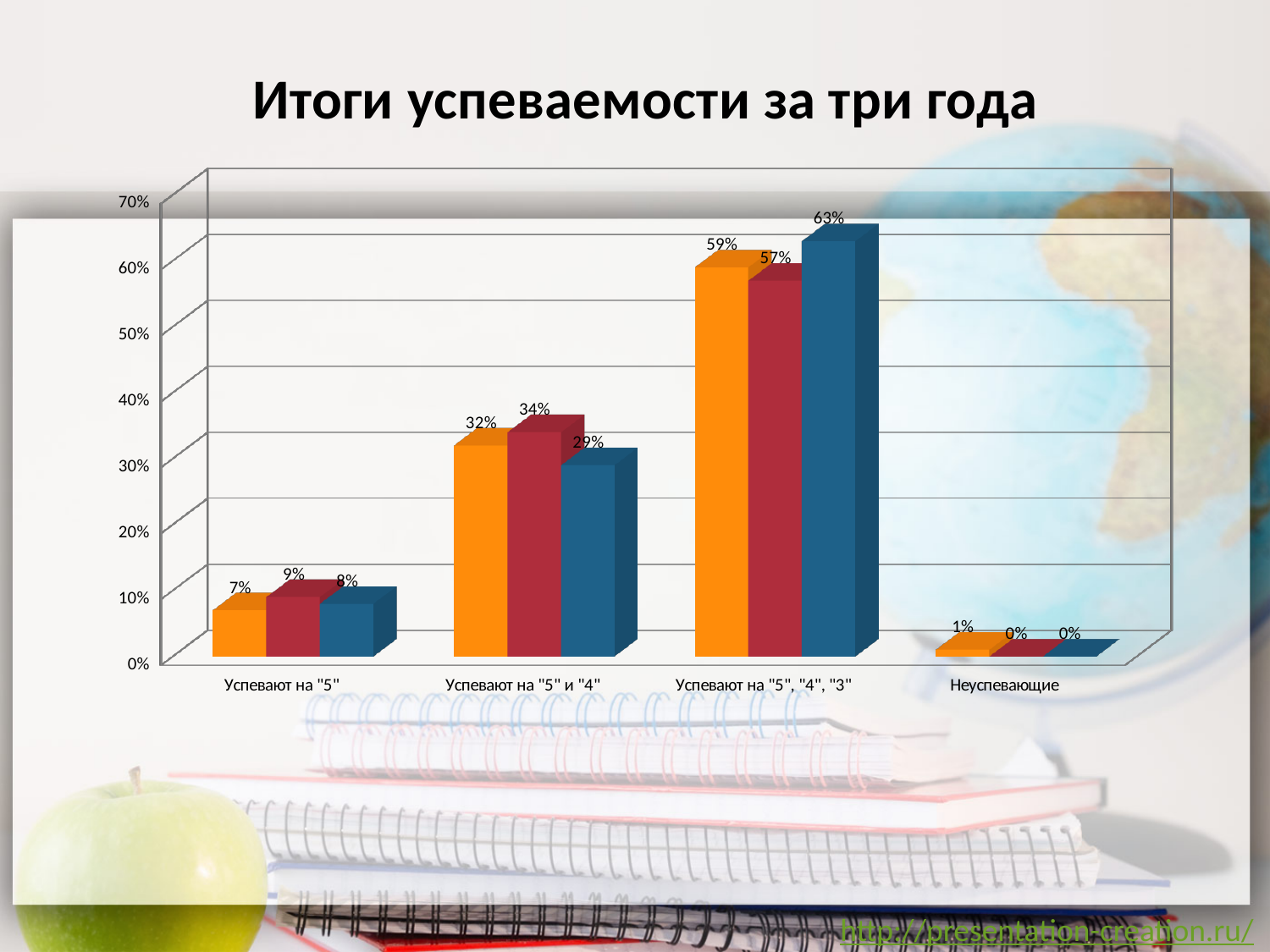
What is the difference between the blue bar and the red bar for the category Успевают на "5", "4", "3"? 6% Which category has the highest values across all three bars? Успевают на "5", "4", "3" What kind of chart is shown on the slide? bar chart What is the value of the red bar for the category Успевают на "5" и "4"? 34% What is the value of the blue bar for the category Успевают на "5", "4", "3"? 63% Which category has the lowest values across all three bars? Неуспевающие What is the title of the slide? Итоги успеваемости за три года How many bars are shown for each category? 3 What is the value of the orange bar for the category Неуспевающие? 1% What is the value of the orange bar for the category Успевают на "5"? 7% How many categories are shown on the x axis? 4 Which is larger for the category Успевают на "5" и "4": the orange bar or the blue bar? the orange bar